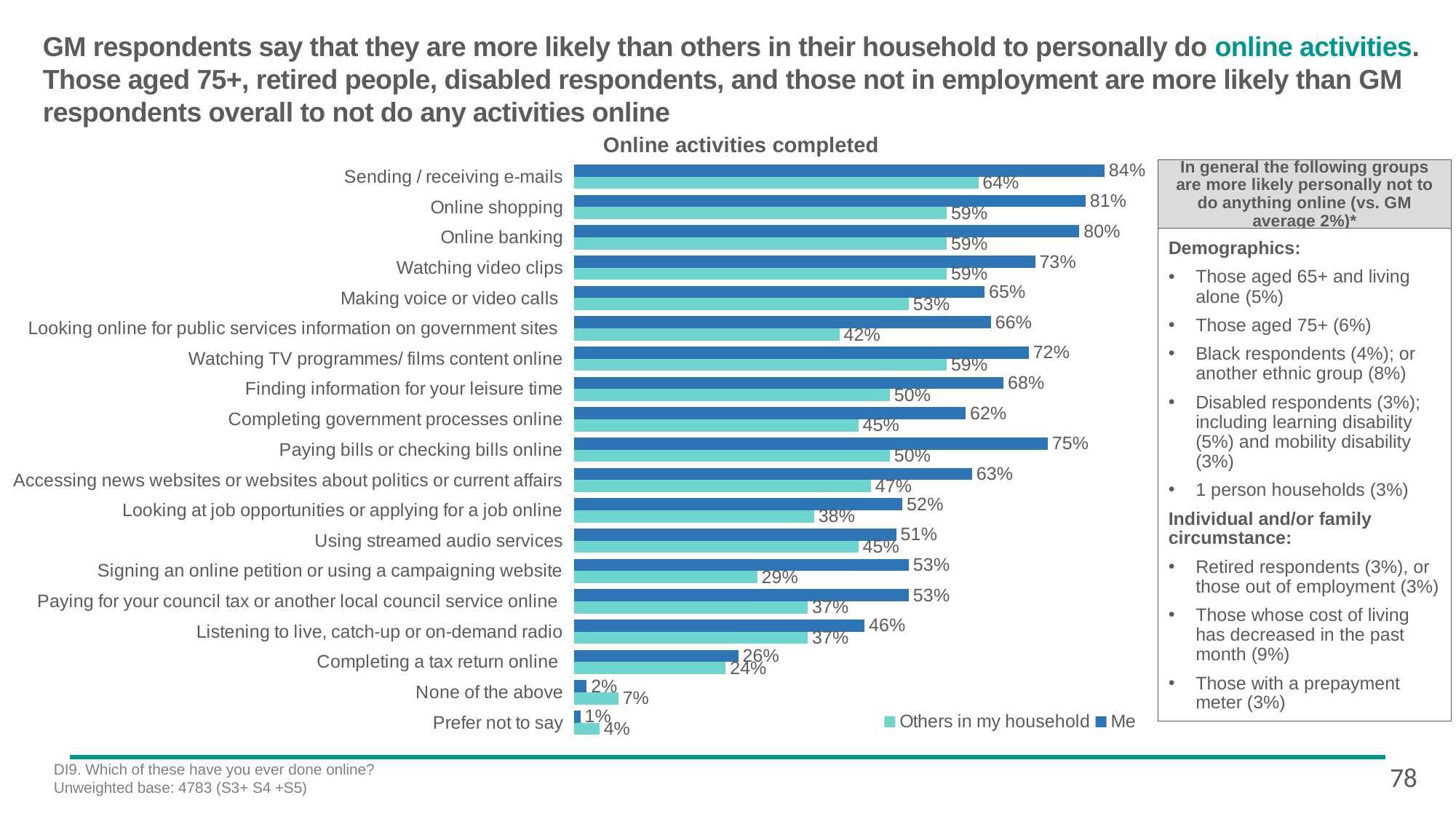
What is the difference between the 'Me' and 'Others in my household' values for Looking online for public services information on government sites? 24 percentage points What percentage of respondents say they personally send / receive e-mails (the 'Me' series)? 84% For None of the above, which is larger: the 'Me' value or the 'Others in my household' value? Others in my household What is the 'Others in my household' value for Online banking? 59% What is the title of the chart? Online activities completed How many categories are shown on the chart? 19 Which activity has the highest 'Me' value? Sending / receiving e-mails What type of chart is shown on the slide? Bar chart What is the 'Others in my household' value for Signing an online petition or using a campaigning website? 29% Which category has the lowest 'Me' value? Prefer not to say What is the 'Me' value for Paying bills or checking bills online? 75% How many series does the legend list? 2